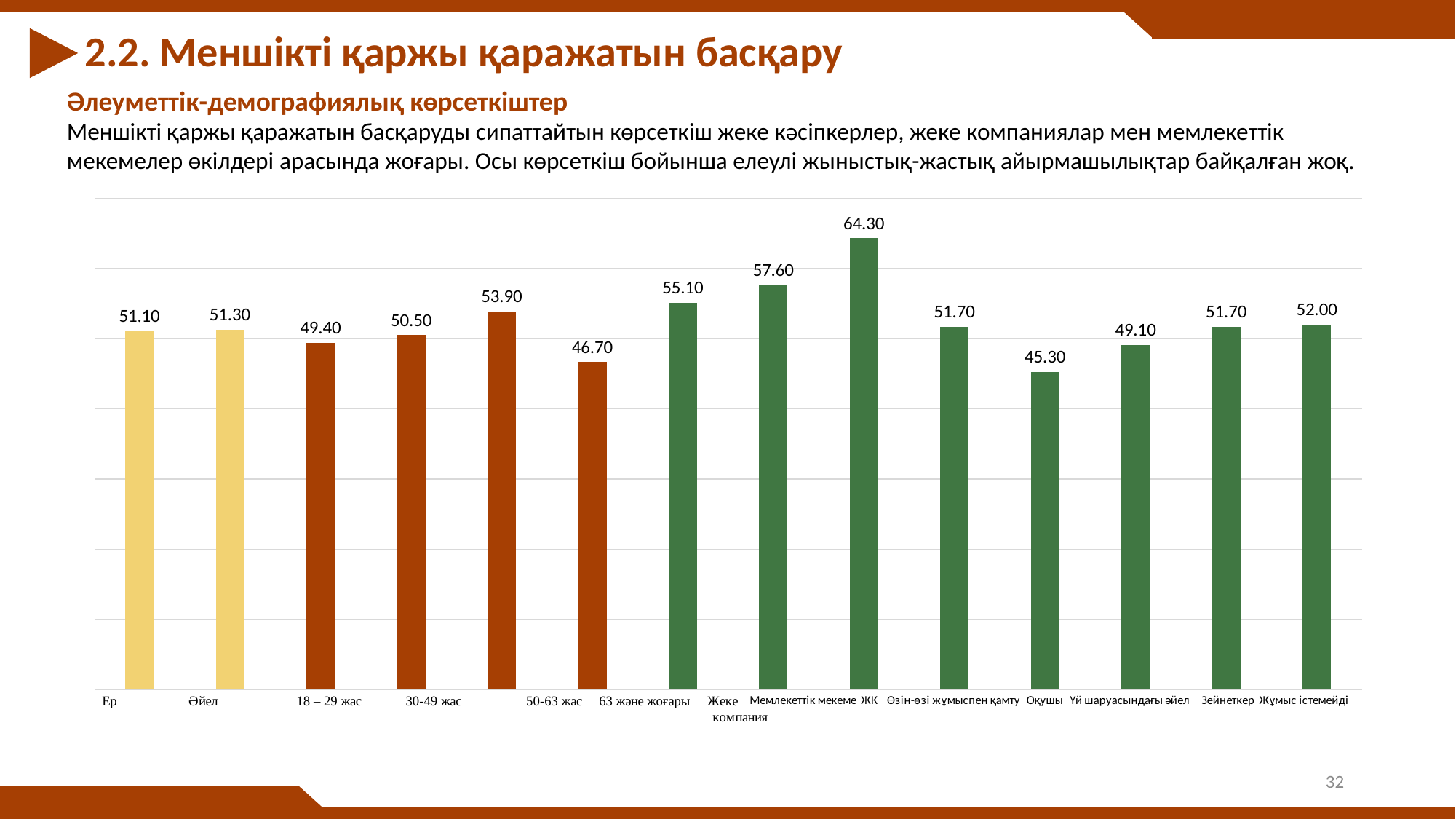
What kind of chart is shown on the slide? Bar chart How many bars are shown in the chart? 14 What is the value for 63 және жоғары? 46.70 Which is larger, the value for 50-63 жас or the value for 18 – 29 жас? 50-63 жас What is the value for Оқушы? 45.30 What is the difference between the values for ЖК and Оқушы? 19.00 Which category has the lowest value? Оқушы Which category has the highest value? ЖК What colour are the bars for Ер and Әйел? Yellow What is the value for Мемлекеттік мекеме? 57.60 What is the difference between the values for Жеке компания and Мемлекеттік мекеме? 2.50 What is the value for ЖК? 64.30